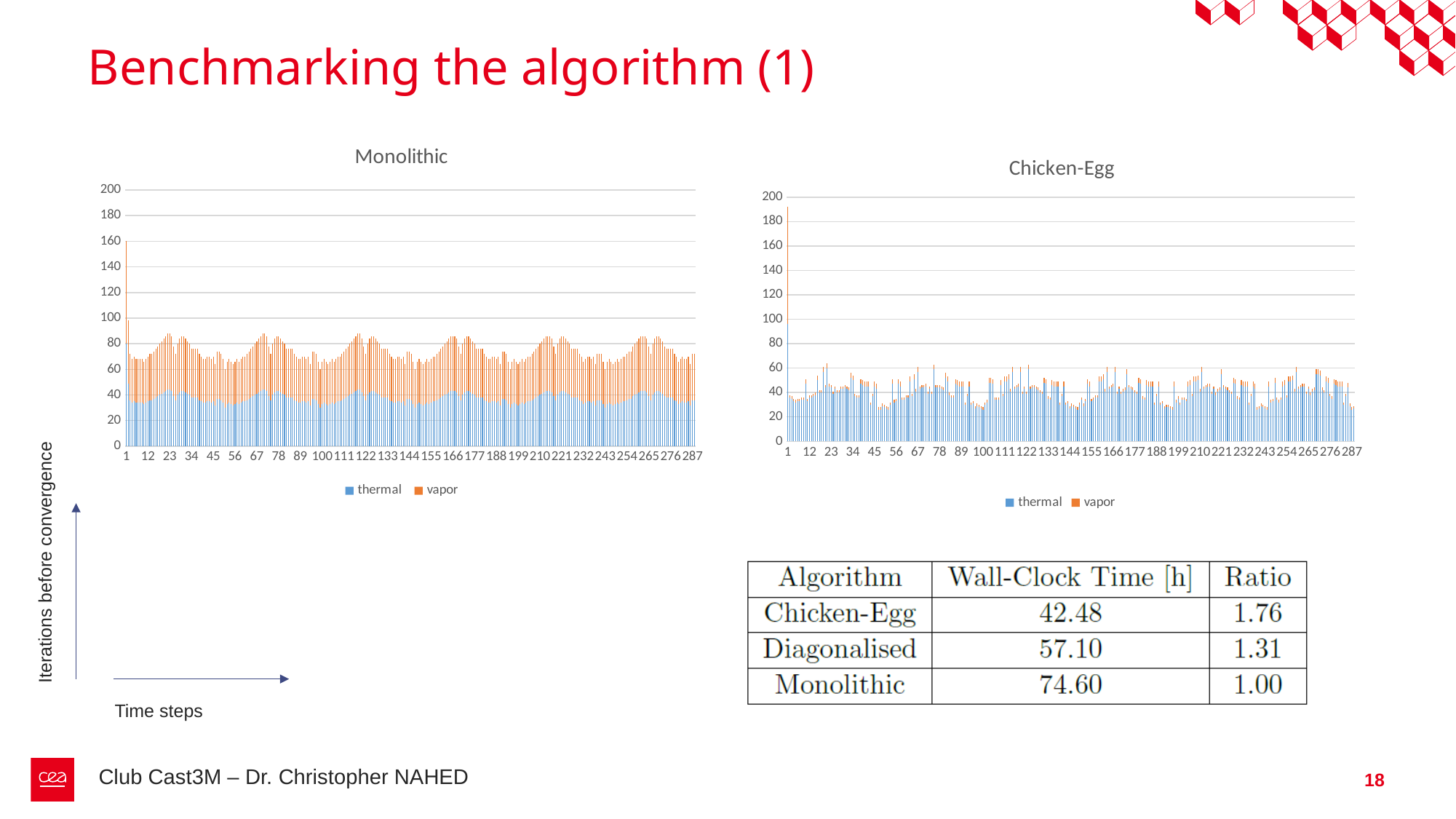
What kind of chart is the Monolithic chart? bar chart In the Monolithic chart, is the total for time step 1 greater or less than 80? greater What is the last time step label shown on the x axis of the Chicken-Egg chart? 287 In the Monolithic chart, is the total for time step 100 greater or less than 100? less Which is larger: the total for time step 1 in the Chicken-Egg chart or the total for time step 1 in the Monolithic chart? Chicken-Egg What is the highest value shown on the y axis of the Monolithic chart? 200 What are the two series named in the legend of the Monolithic chart? thermal and vapor In the Chicken-Egg chart, is the total for time step 1 greater or less than 160? greater In the Chicken-Egg chart, which time step has the highest stacked bar? 1 How many series does the legend of the Chicken-Egg chart list? 2